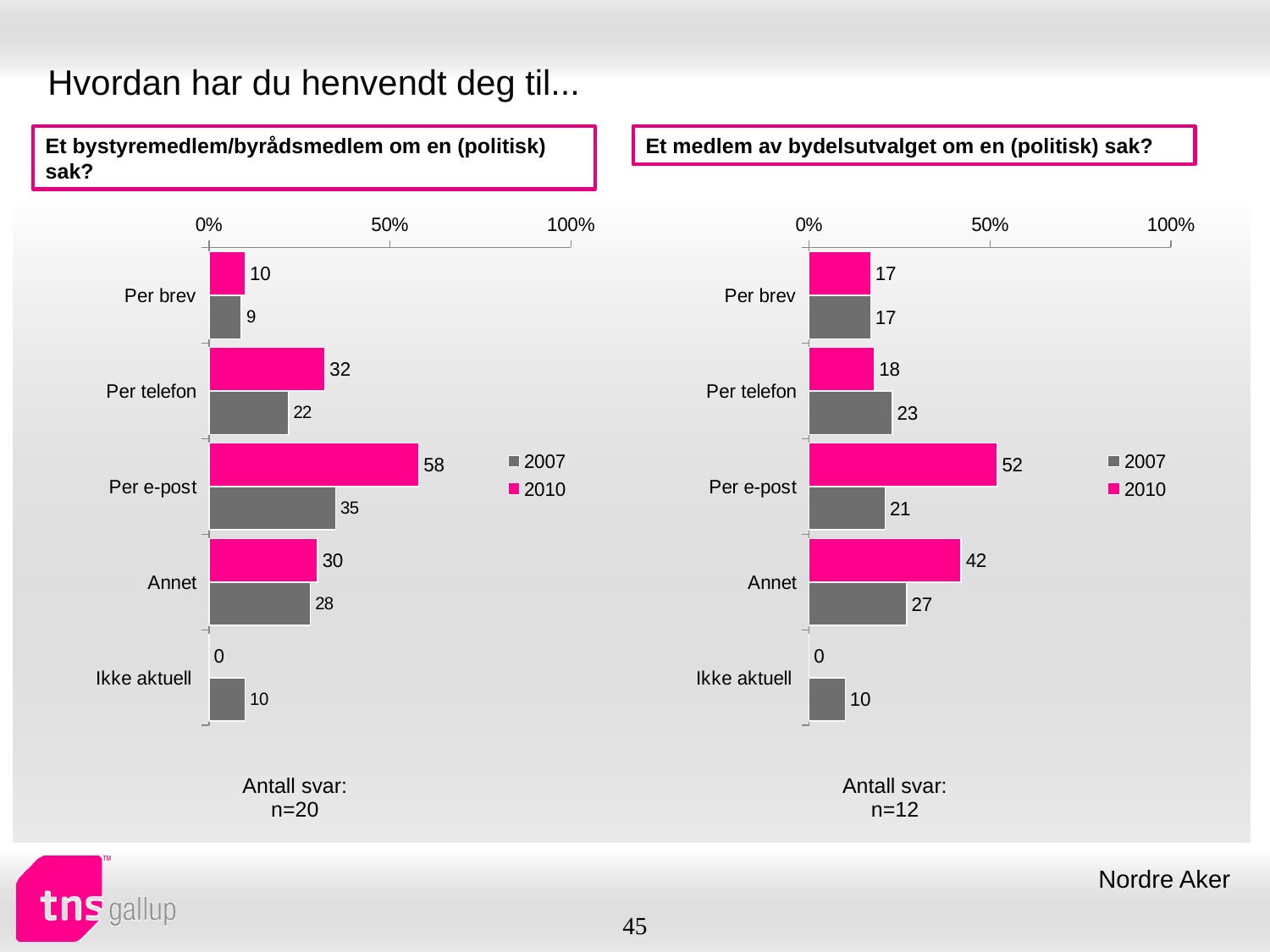
In the left chart (Et bystyremedlem/byrådsmedlem om en (politisk) sak?), what is the value for Per telefon in 2007? 22 In the right chart (Et medlem av bydelsutvalget om en (politisk) sak?), what is the difference between the 2010 and 2007 values for Per e-post? 31 In the left chart (Et bystyremedlem/byrådsmedlem om en (politisk) sak?), what is the value for Per e-post in 2010? 58 How many series does the legend of the right chart (Et medlem av bydelsutvalget om en (politisk) sak?) list? 2 What type of chart is the left chart (Et bystyremedlem/byrådsmedlem om en (politisk) sak?)? Bar chart In the right chart (Et medlem av bydelsutvalget om en (politisk) sak?), what is the value for Per e-post in 2007? 21 In the right chart (Et medlem av bydelsutvalget om en (politisk) sak?), which is larger for Per telefon: the 2007 value or the 2010 value? 2007 In the left chart (Et bystyremedlem/byrådsmedlem om en (politisk) sak?), how many categories are shown? 5 In the right chart (Et medlem av bydelsutvalget om en (politisk) sak?), what is the value for Annet in 2010? 42 In the right chart (Et medlem av bydelsutvalget om en (politisk) sak?), which category has the lowest value for 2010? Ikke aktuell In the left chart (Et bystyremedlem/byrådsmedlem om en (politisk) sak?), which category has the highest value for 2010? Per e-post In the left chart (Et bystyremedlem/byrådsmedlem om en (politisk) sak?), what is the difference between the 2010 and 2007 values for Per e-post? 23